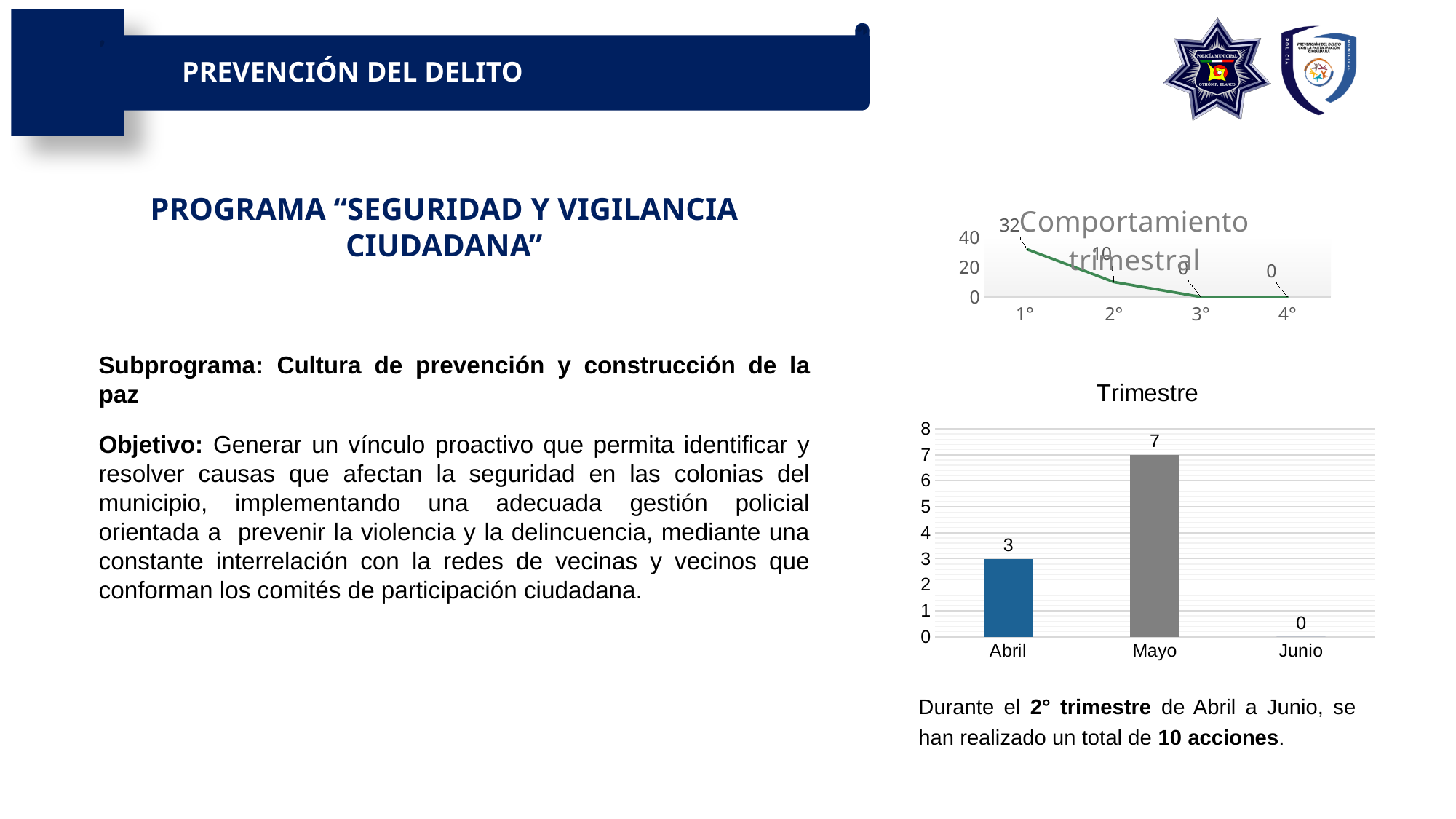
In the "Comportamiento trimestral" chart, what is the value for 1°? 32 In the "Trimestre" chart, what is the value for Junio? 0 In the "Trimestre" chart, what is the difference between the values for Mayo and Abril? 4 In the "Trimestre" chart, which month has the lowest value? Junio In the "Trimestre" chart, what is the value for Abril? 3 In the "Trimestre" chart, what is the value for Mayo? 7 In the "Trimestre" chart, which month has the highest value? Mayo What kind of chart is the "Trimestre" chart? Bar chart In the "Trimestre" chart, how many months are shown on the x axis? 3 What kind of chart is the "Comportamiento trimestral" chart? Line chart In the "Comportamiento trimestral" chart, do the values rise or fall from 1° to 4°? Fall In the "Comportamiento trimestral" chart, what is the value for 4°? 0